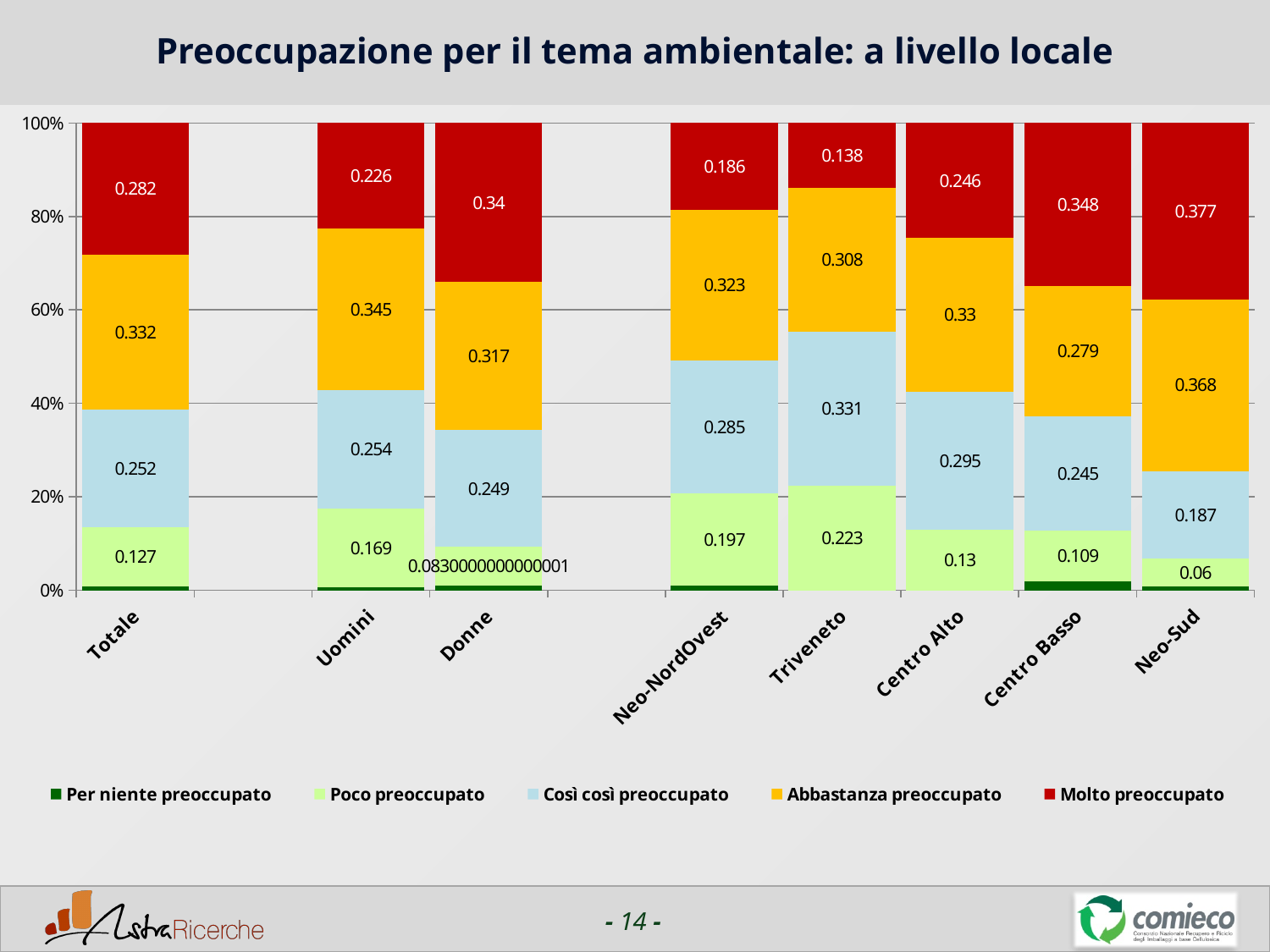
Which category has the lowest value for Poco preoccupato? Neo-Sud Which category has the highest value for Così così preoccupato? Triveneto How many categories are shown on the x axis? 8 What is the value of Abbastanza preoccupato for Uomini? 0.345 How many series does the legend list? 5 What is the value of Così così preoccupato for Centro Alto? 0.295 Which has the larger Abbastanza preoccupato value, Neo-NordOvest or Centro Basso? Neo-NordOvest What is the value of Poco preoccupato for Triveneto? 0.223 What is the difference between the Molto preoccupato values for Donne and Uomini? 0.114 What kind of chart is shown on the slide? Stacked bar chart What is the value of Molto preoccupato for Neo-Sud? 0.377 Which category has the highest value for Molto preoccupato? Neo-Sud